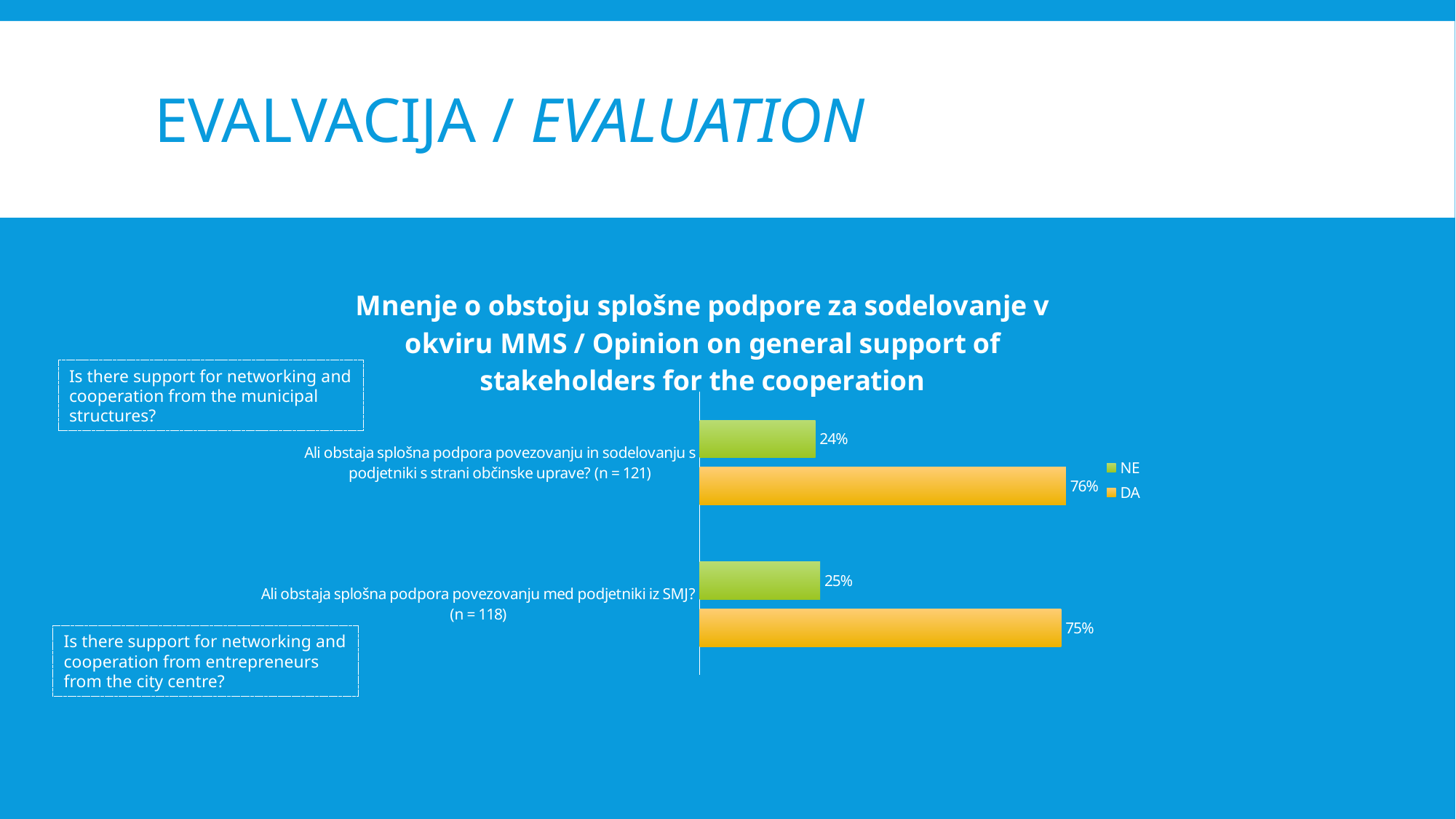
For the question with n = 118, which is larger, the DA value or the NE value? DA What is the DA value for the question about support from the municipal administration (n = 121)? 76% What is the DA value for the question about support among entrepreneurs from SMJ (n = 118)? 75% Which colour represents the DA series? orange What is the NE value for the question about support from the municipal administration (n = 121)? 24% What is the NE value for the question about support among entrepreneurs from SMJ (n = 118)? 25% What are the two series named in the legend? NE and DA How many series does the legend list? 2 For the question with n = 121, what is the difference between the DA and NE values? 52% What kind of chart is shown on the slide? bar chart How many question categories are plotted on the chart? 2 For the question with n = 118, what is the difference between the DA and NE values? 50%